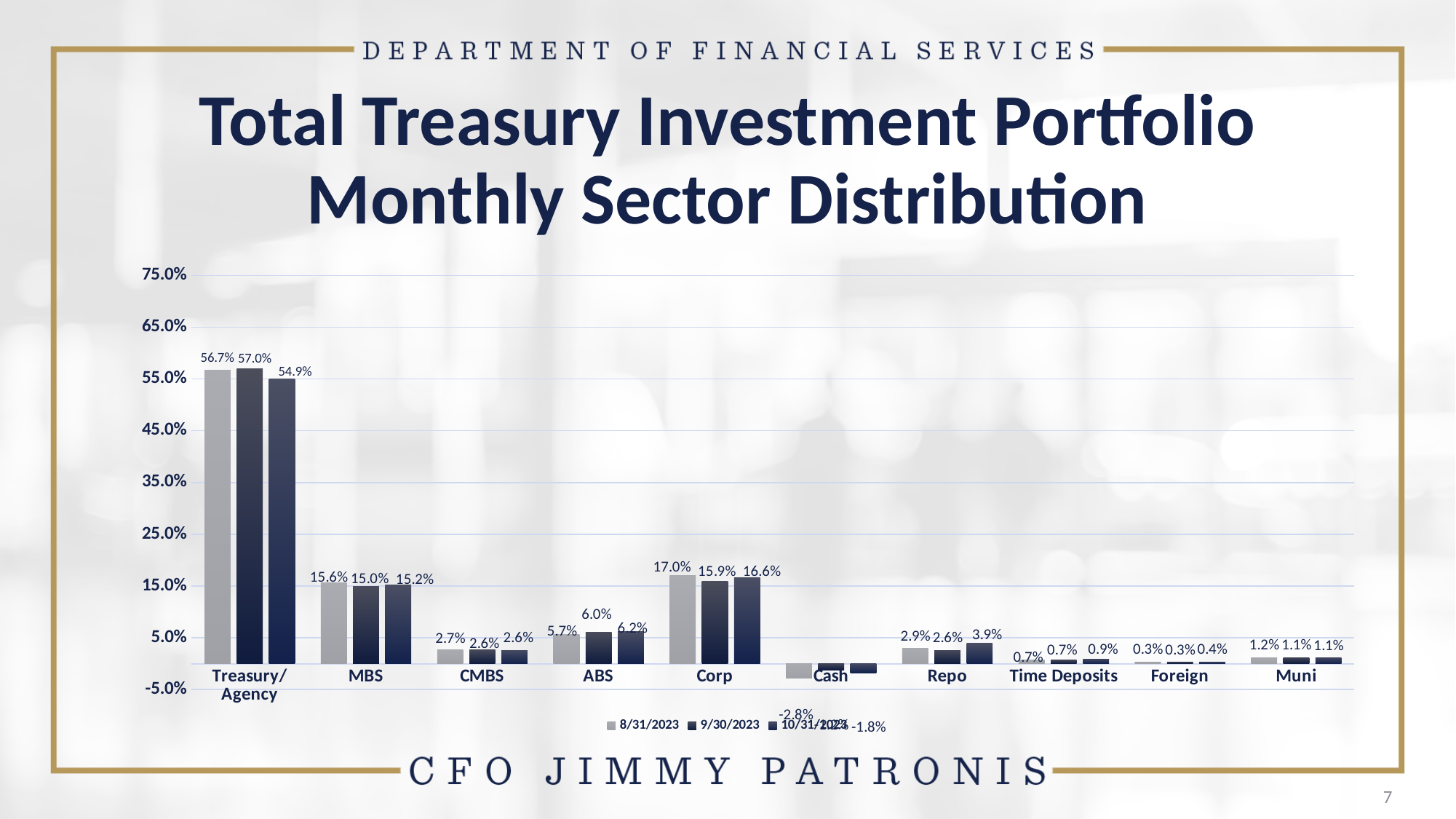
What kind of chart is shown on the slide? Bar chart Which is larger for MBS: the 8/31/2023 value or the 9/30/2023 value? 8/31/2023 What is the difference between the 8/31/2023 and 10/31/2023 values for Treasury/Agency? 1.8% Is the value for Corp for 10/31/2023 greater or less than 15.0%? greater Which sector has the highest value for 9/30/2023? Treasury/Agency How many sector categories are shown on the x axis? 10 Which sector has the lowest value for 8/31/2023? Cash What is the value for Repo for 10/31/2023? 3.9% What is the value for Treasury/Agency for 10/31/2023? 54.9% What is the title of the chart on the slide? Total Treasury Investment Portfolio Monthly Sector Distribution What is the value for Corp for 8/31/2023? 17.0% How many series does the legend list? 3